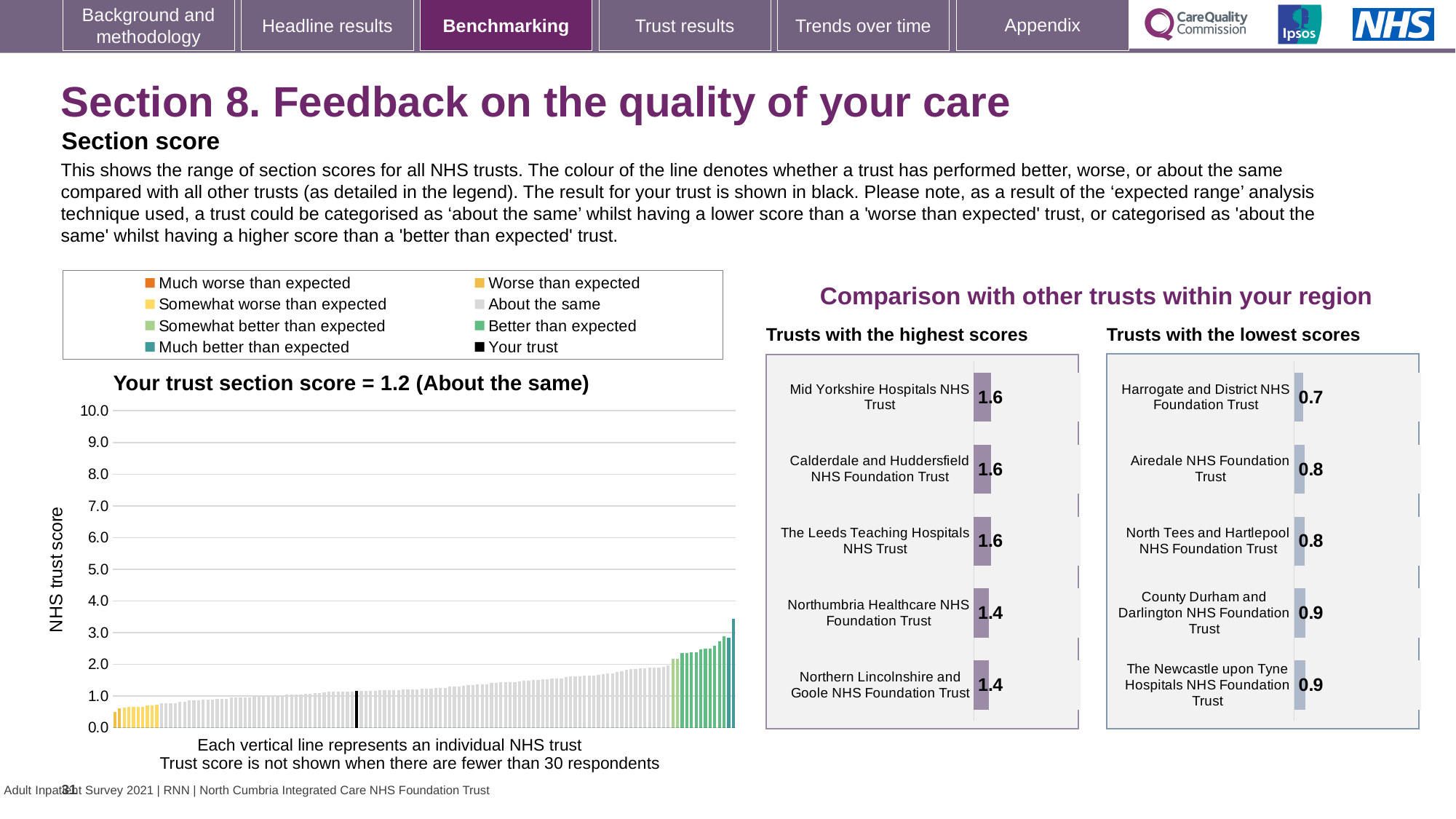
What kind of chart is the 'Your trust section score' chart? bar chart In the 'Trusts with the highest scores' chart, what is the score for Northumbria Healthcare NHS Foundation Trust? 1.4 In the 'Your trust section score' chart, what is the label on the y axis? NHS trust score In the 'Trusts with the highest scores' chart, how many trusts are shown? 5 How many entries does the legend above the 'Your trust section score' chart list? 8 In the chart titled 'Your trust section score', what is the section score for your trust? 1.2 In the 'Your trust section score' chart, is the value of the tallest bar greater or less than 3.0? greater In the 'Your trust section score' chart, do the trust scores rise or fall from left to right along the x axis? rise In the 'Trusts with the lowest scores' chart, which has the larger score: Harrogate and District NHS Foundation Trust or The Newcastle upon Tyne Hospitals NHS Foundation Trust? The Newcastle upon Tyne Hospitals NHS Foundation Trust In the 'Trusts with the lowest scores' chart, what is the score for Airedale NHS Foundation Trust? 0.8 In the 'Trusts with the highest scores' chart, what is the difference between the scores of Mid Yorkshire Hospitals NHS Trust and Northern Lincolnshire and Goole NHS Foundation Trust? 0.2 In the 'Trusts with the lowest scores' chart, which trust has the lowest score? Harrogate and District NHS Foundation Trust